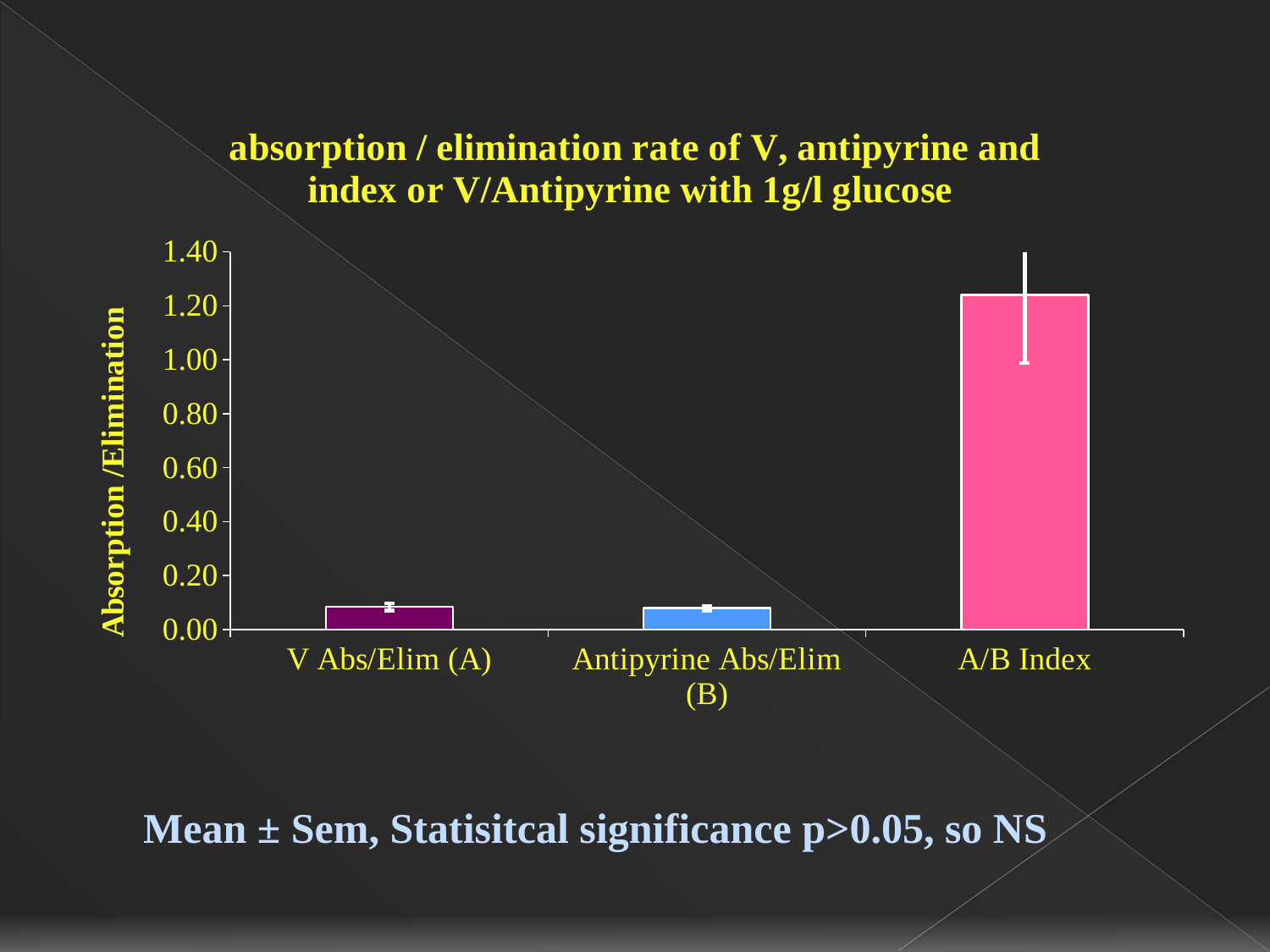
Which category has the highest value? A/B Index Which is larger, the value for A/B Index or the value for V Abs/Elim (A)? A/B Index How many categories are plotted on the x axis? 3 Is the value for A/B Index greater or less than 1.00? greater What is the label of the y axis? Absorption /Elimination What kind of chart is shown on the slide? bar chart Which is larger, the value for Antipyrine Abs/Elim (B) or the value for A/B Index? A/B Index Is the value for V Abs/Elim (A) greater or less than 0.20? less Is the value for Antipyrine Abs/Elim (B) greater or less than 0.20? less What colour is the bar for A/B Index? pink